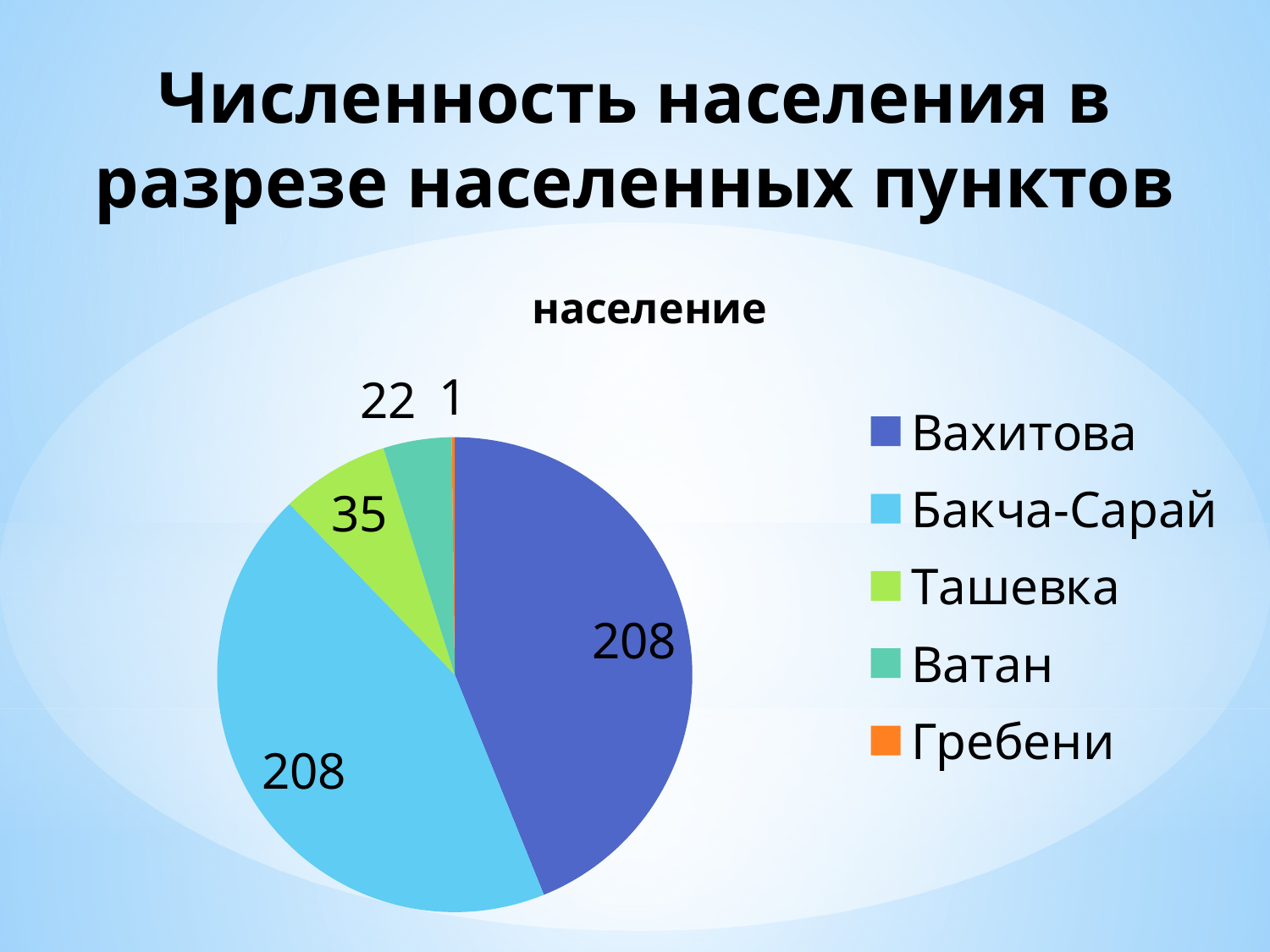
What is the value for Ватан? 22 What is the value for Вахитова? 208 What is the value for Гребени? 1 What is the total of all the values in the pie chart? 474 Which is larger, the value for Ташевка or the value for Ватан? Ташевка What kind of chart is shown on the slide? pie chart What is the value for Ташевка? 35 How many categories does the pie chart have? 5 Which category has the smallest value? Гребени What is the difference between the values for Вахитова and Ташевка? 173 What is the difference between the values for Ташевка and Ватан? 13 What is the title of the chart? население